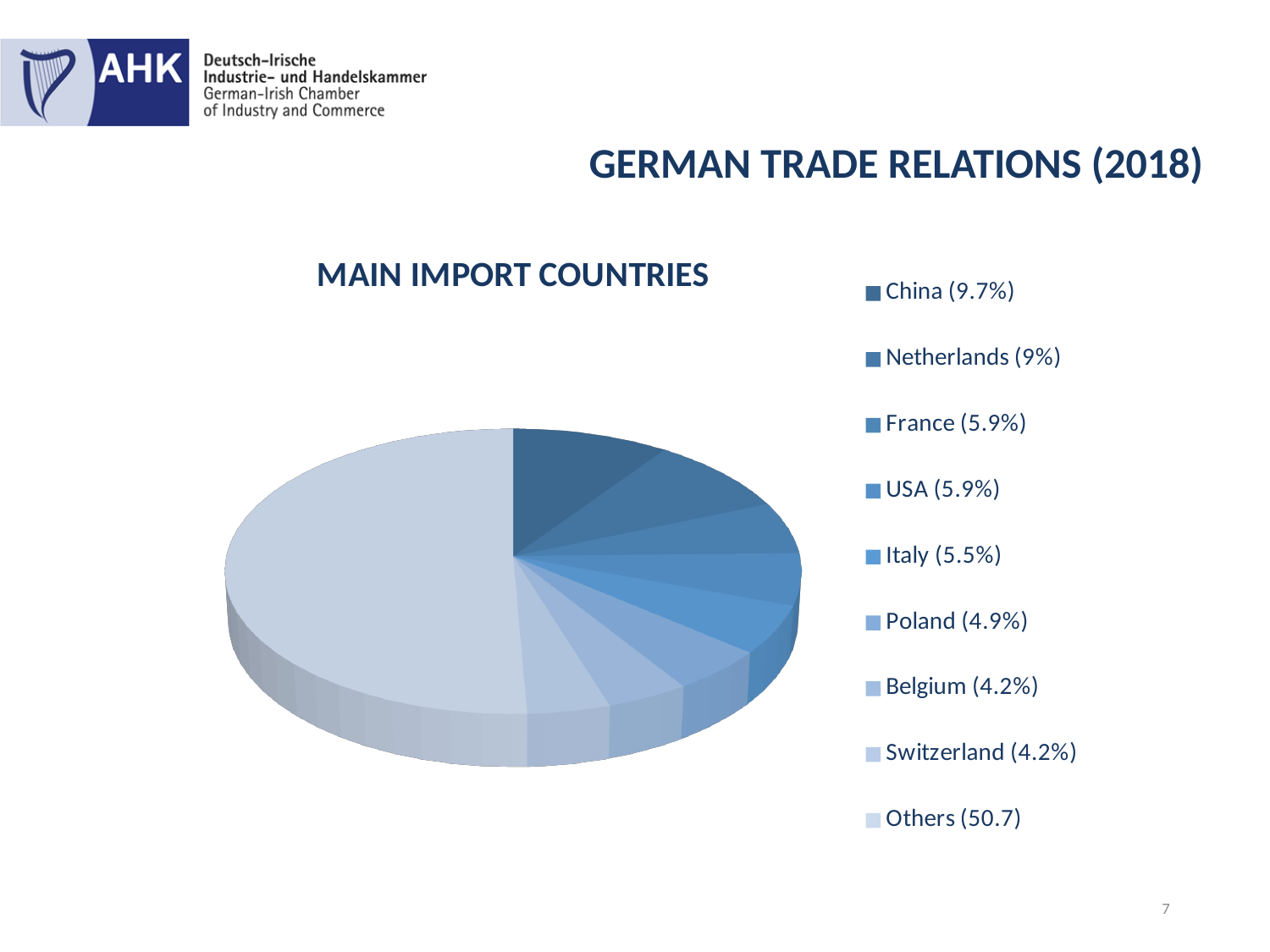
Which named country has the largest share of imports? China Which has a larger share, Italy or Poland? Italy What is the difference between the shares of France and Belgium? 1.7 percentage points Which category has the largest slice of the pie? Others What is the value shown for Poland? 4.9% What is the value shown for Netherlands? 9% What is the title of the chart? MAIN IMPORT COUNTRIES What kind of chart is shown on the slide? pie chart What is the difference between the shares of China and Netherlands? 0.7 percentage points What is the value shown for Others? 50.7 What share of the pie does China have? 9.7% How many categories does the pie chart have? 9